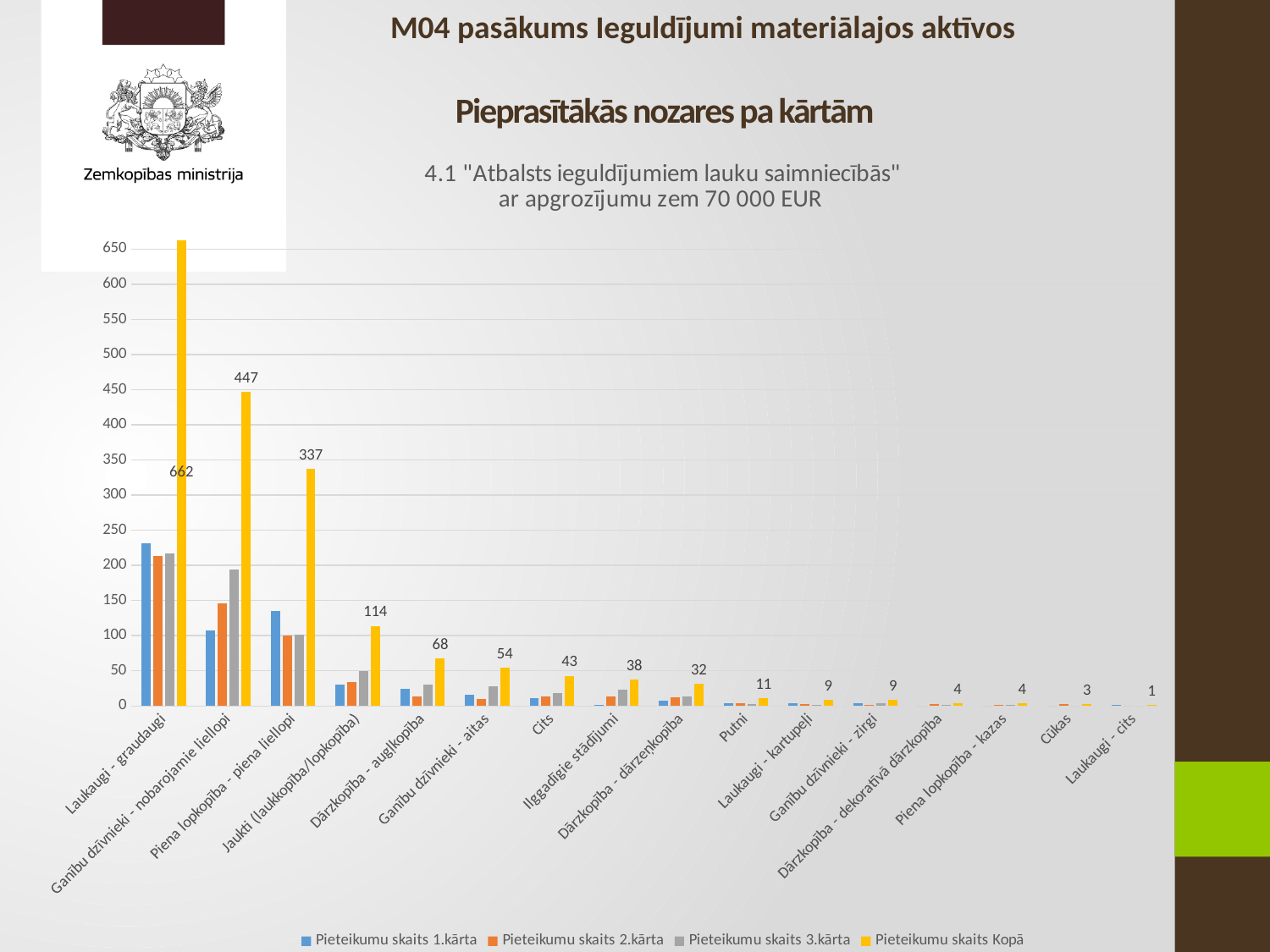
What is the value of Pieteikumu skaits Kopā for Laukaugi - graudaugi? 662 How many categories are shown on the x axis of the chart? 16 Which category has the highest Pieteikumu skaits Kopā value? Laukaugi - graudaugi Is the Pieteikumu skaits 3.kārta value for Ganību dzīvnieki - nobarojamie liellopi greater or less than 150? greater Which category has the lowest Pieteikumu skaits Kopā value? Laukaugi - cits What kind of chart is shown on the slide? Bar chart What is the value of Pieteikumu skaits Kopā for Jaukti (laukkopība/lopkopība)? 114 Is the Pieteikumu skaits 1.kārta value for Laukaugi - graudaugi greater or less than 200? greater How many series does the legend list? 4 Which has a larger Pieteikumu skaits Kopā value, Dārzkopība - augļkopība or Cits? Dārzkopība - augļkopība What is the difference between the Pieteikumu skaits Kopā values for Laukaugi - graudaugi and Piena lopkopība - piena liellopi? 325 What is the value of Pieteikumu skaits Kopā for Ganību dzīvnieki - nobarojamie liellopi? 447